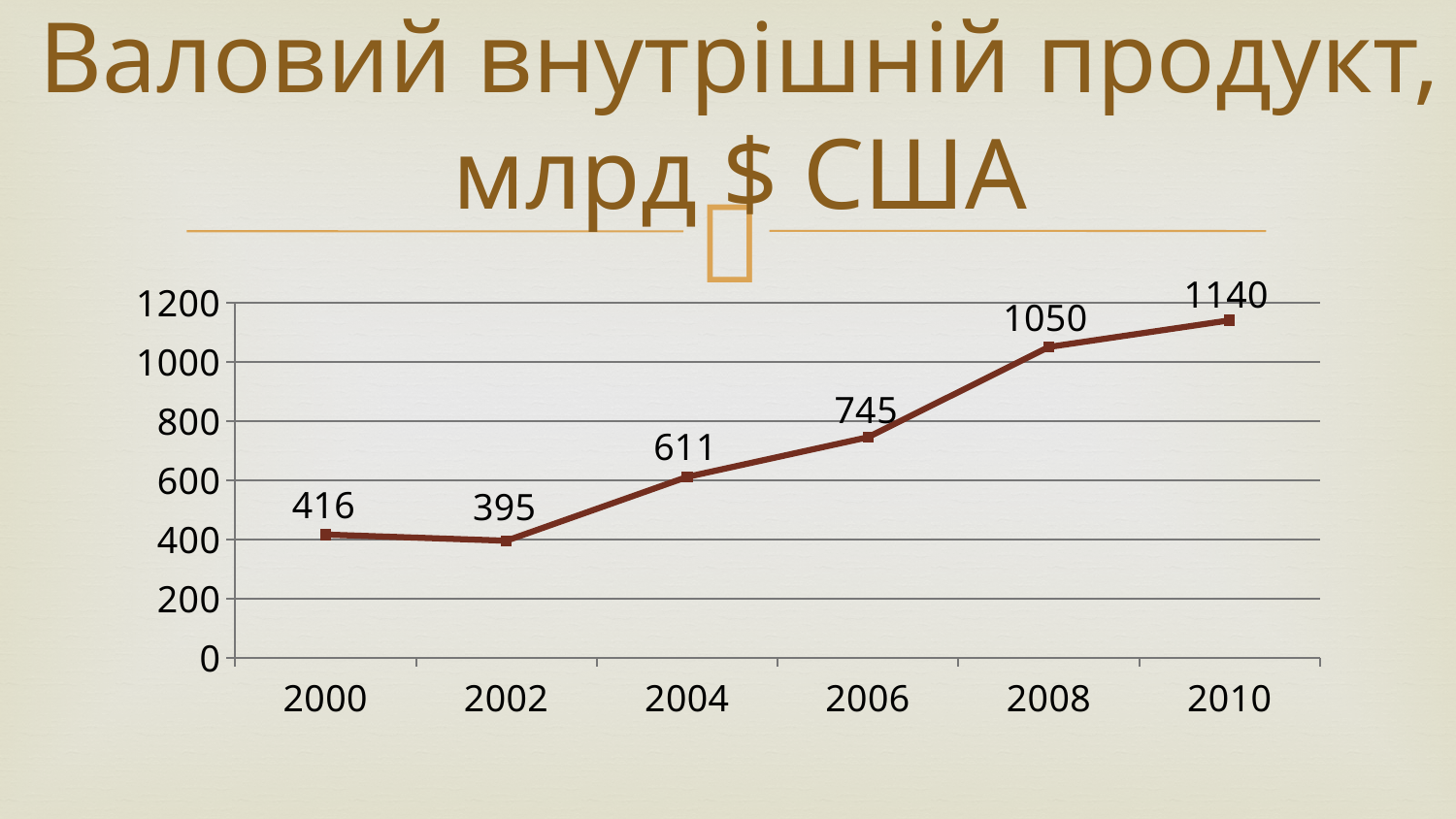
What is the GDP value for 2004? 611 Is the GDP value for 2006 greater or less than 800? less What is the difference between the GDP values for 2010 and 2008? 90 How many years are plotted on the chart? 6 Which year has the highest GDP value? 2010 What is the GDP value for 2000? 416 What is the GDP value for 2008? 1050 What kind of chart is shown on the slide? line chart Does the GDP value rise or fall from 2002 to 2010? rise Which year has the lowest GDP value? 2002 Which is larger, the GDP value for 2000 or for 2002? 2000 What is the difference between the GDP values for 2006 and 2004? 134